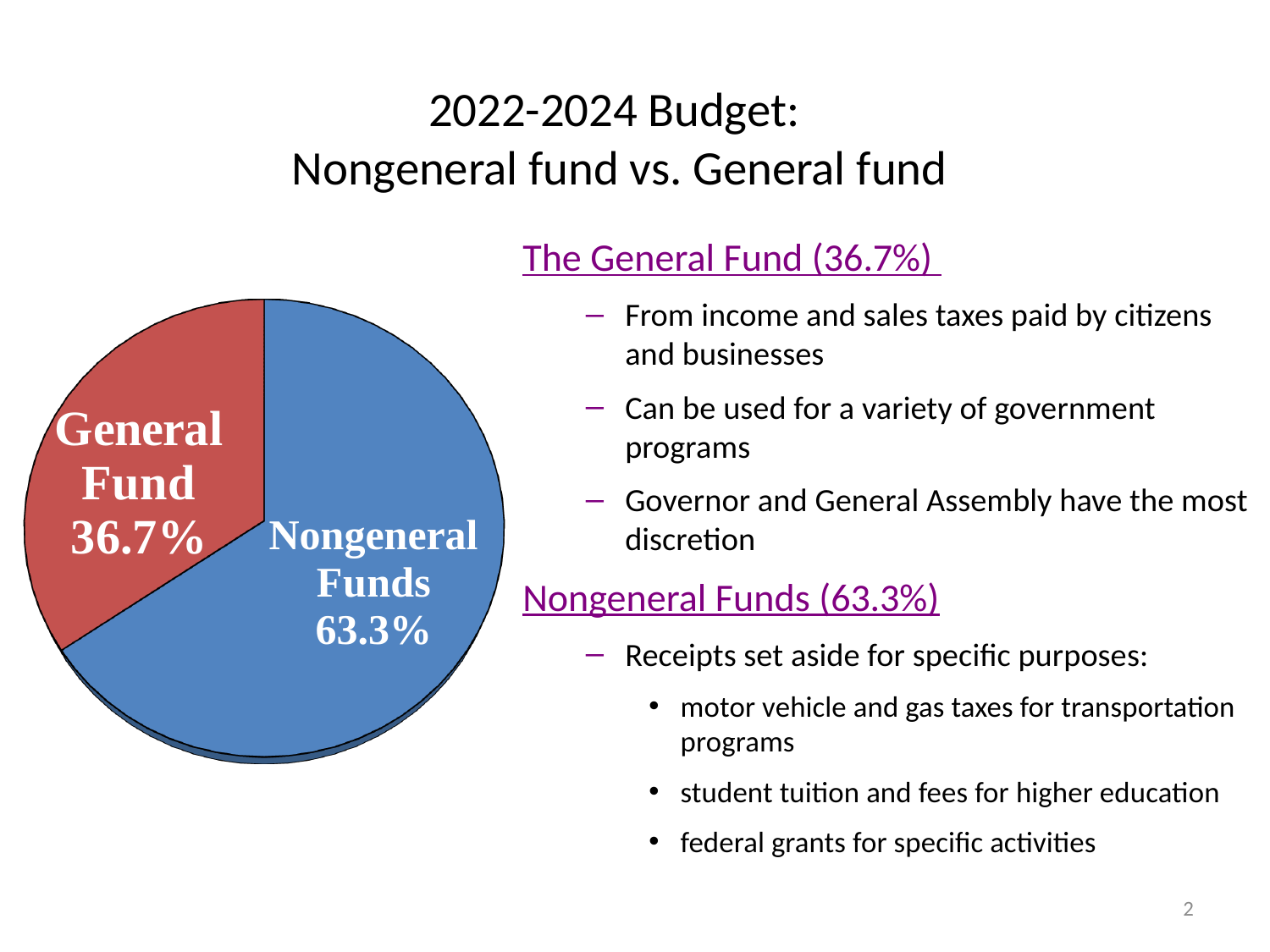
What colour is the General Fund slice of the pie? red Which slice of the pie is the largest? Nongeneral Funds What is the difference in percentage points between the Nongeneral Funds slice and the General Fund slice? 26.6 What share of the pie does the Nongeneral Funds slice represent? 63.3% What kind of chart is shown on the slide? pie chart Which is larger, the General Fund slice or the Nongeneral Funds slice? Nongeneral Funds What share of the pie does the General Fund slice represent? 36.7% What colour is the Nongeneral Funds slice of the pie? blue How many slices does the pie chart have? 2 Which slice of the pie is the smallest? General Fund